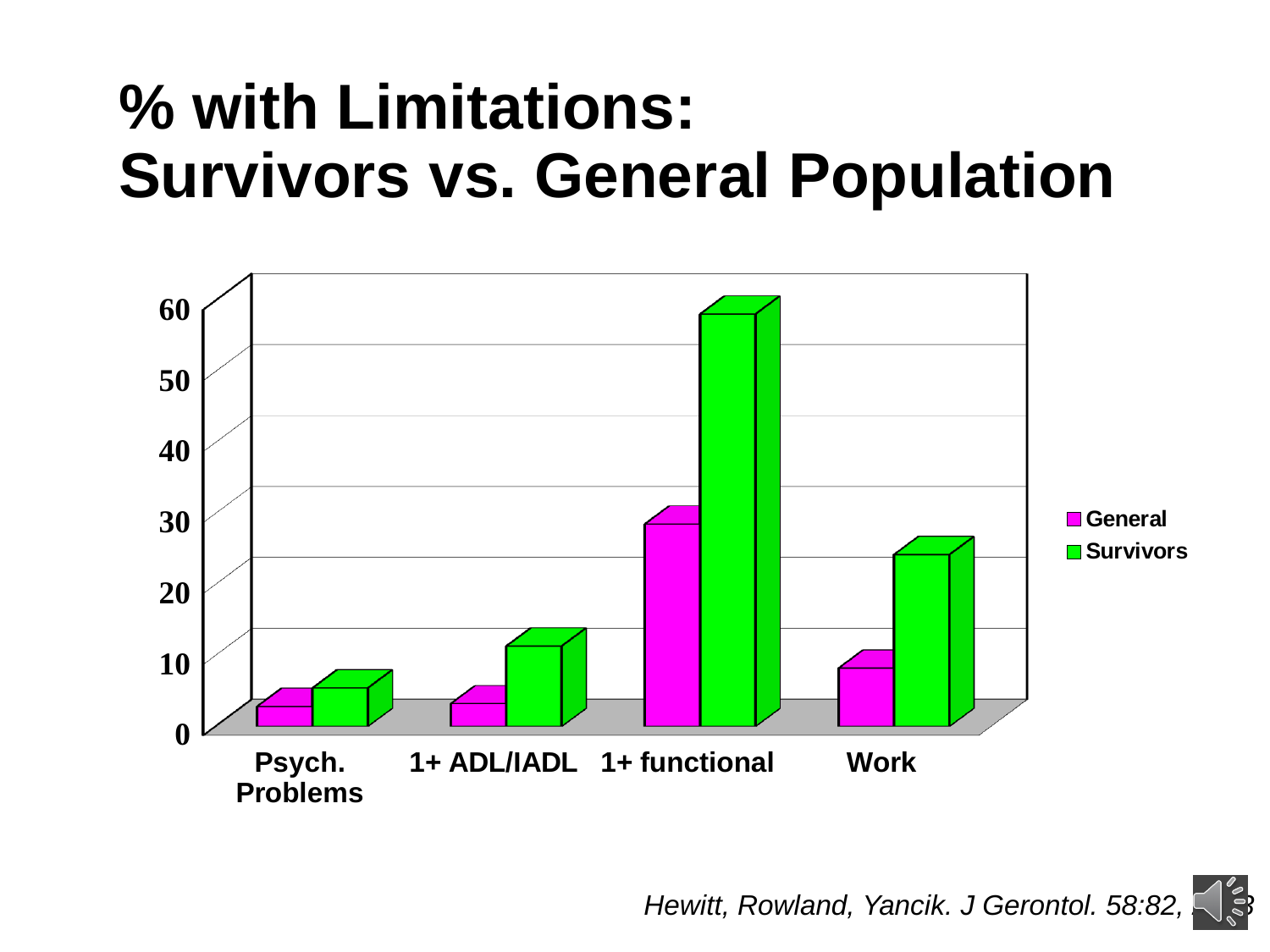
Is the Survivors value for 1+ functional greater or less than 50? greater For the Work category, which series has the larger value, General or Survivors? Survivors How many series does the legend list? 2 What colour are the bars for the Survivors series? green Which category has the highest value for Survivors? 1+ functional Which category has the highest value for General? 1+ functional What kind of chart is shown on the slide? bar chart Is the Survivors value for Work greater or less than 20? greater Is the Survivors value for 1+ ADL/IADL greater or less than 10? greater How many categories are shown on the x axis? 4